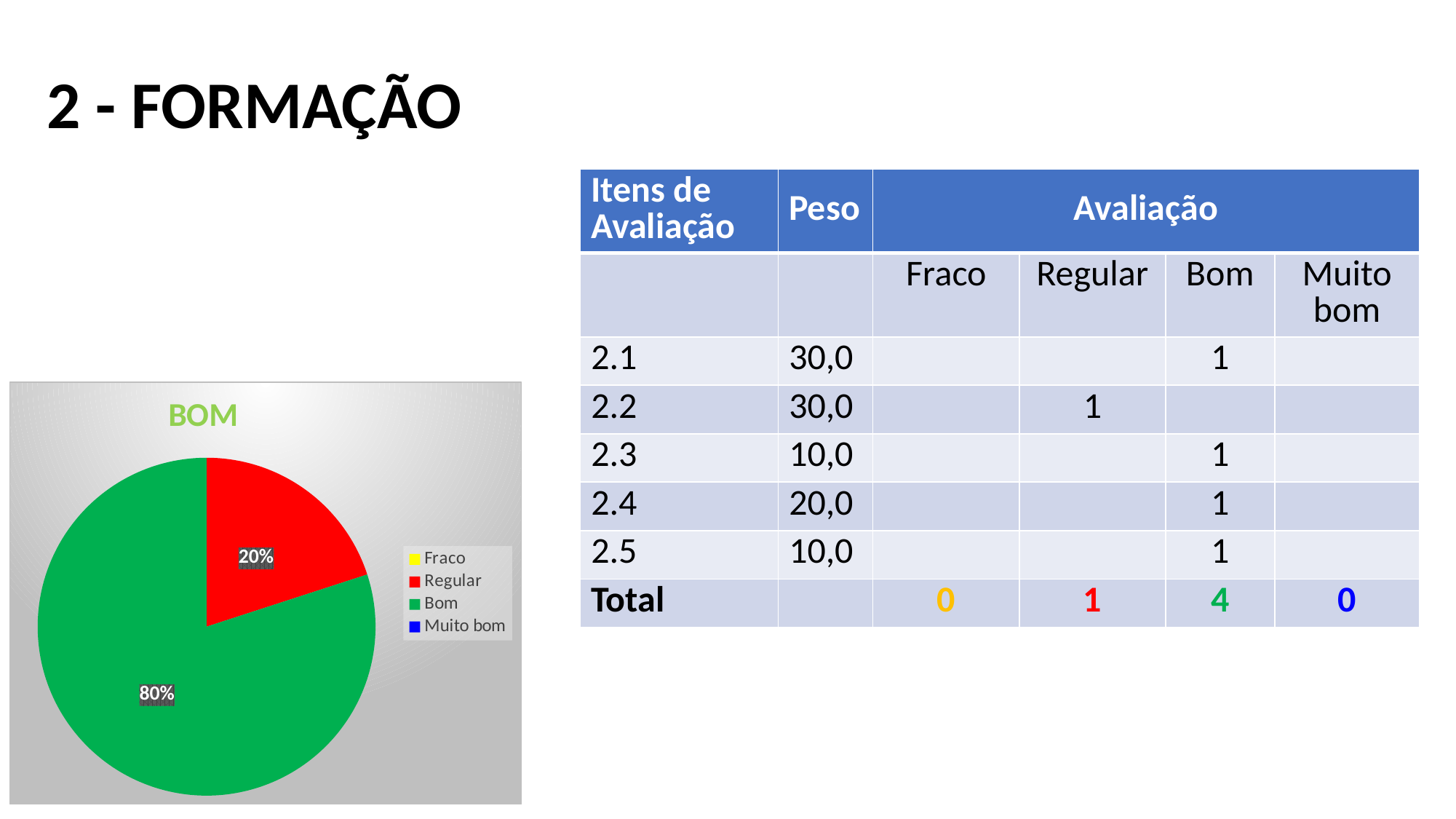
What kind of chart is shown on the slide? pie chart How many slices with a visible share are shown in the pie chart? 2 What colour is the Bom slice in the pie chart? green What share of the pie does the Bom slice represent? 80% What is the title of the pie chart? BOM How many entries does the pie chart's legend list? 4 What share of the pie does the Regular slice represent? 20% What is the difference in percentage points between the Bom slice and the Regular slice? 60% Is the share for Bom greater or less than 50%? greater Which category has the largest slice in the pie chart? Bom Which legend entry is shown in red in the pie chart? Regular Which is larger in the pie chart, the Bom slice or the Regular slice? Bom